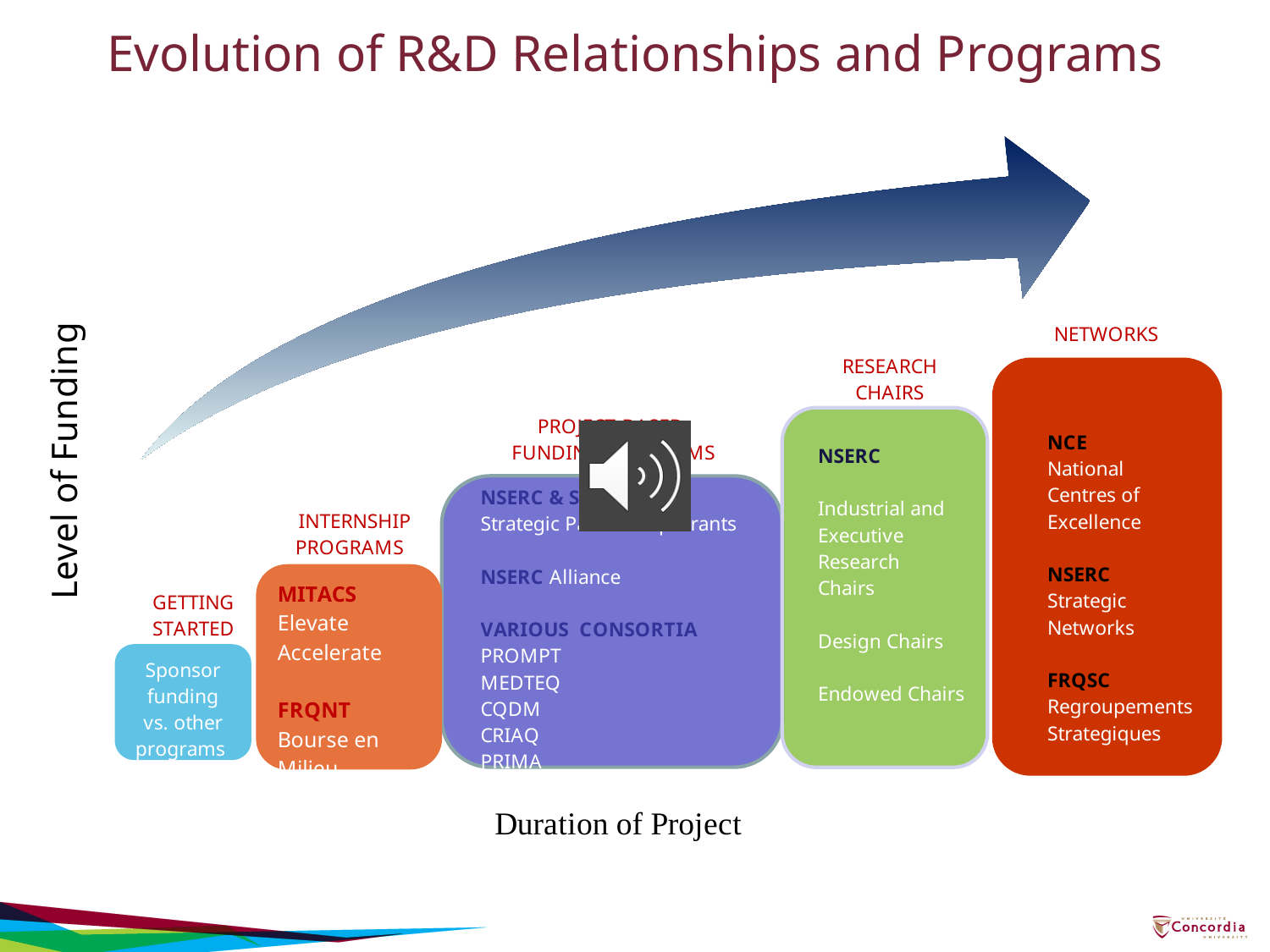
How many program stages (boxes) are shown along the horizontal axis? 5 Which stage is shown at the highest level of funding? Networks What is the label on the horizontal axis of the diagram? Duration of Project What is the label on the vertical axis of the diagram? Level of Funding Which stage is shown at the lowest level of funding? Getting Started Which stage is shown at a higher level of funding, Project Based Funding Programs or Getting Started? Project Based Funding Programs Which stage is shown at a higher level of funding, Internship Programs or Research Chairs? Research Chairs Does the level of funding rise or fall as the duration of project increases along the x axis? rise